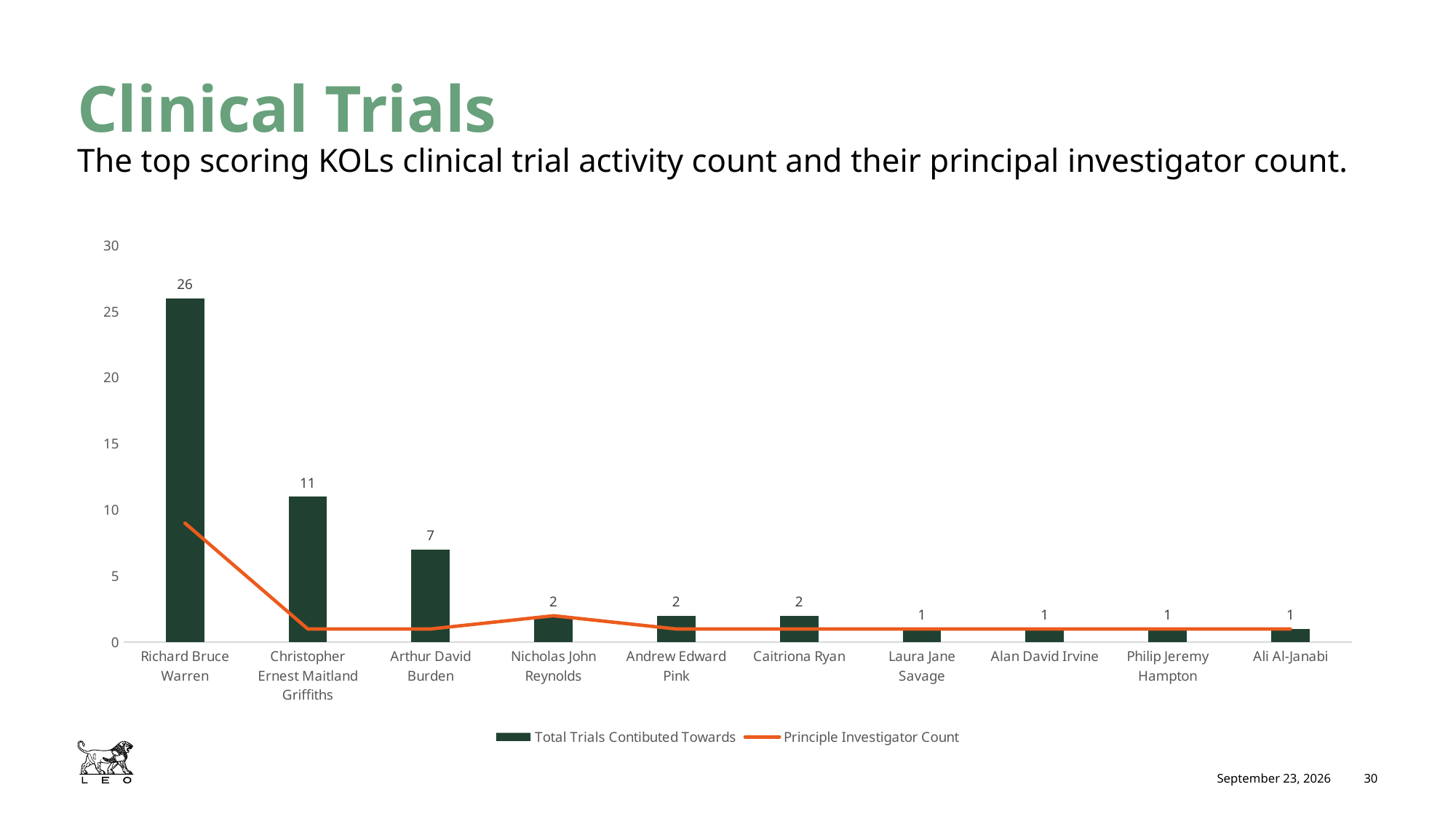
Do the Total Trials Contributed Towards values rise or fall from left to right along the x axis? fall What is the Total Trials Contributed Towards value for Caitriona Ryan? 2 Who has a higher Total Trials Contributed Towards value, Arthur David Burden or Nicholas John Reynolds? Arthur David Burden How many KOLs are shown on the x axis of the chart? 10 Is the Principle Investigator Count for Richard Bruce Warren greater or less than 5? greater Which series is shown as an orange line in the chart? Principle Investigator Count What is the Total Trials Contributed Towards value for Richard Bruce Warren? 26 Which KOL has the highest Total Trials Contributed Towards value? Richard Bruce Warren How many series does the chart legend list? 2 What is the Total Trials Contributed Towards value for Christopher Ernest Maitland Griffiths? 11 What is the Total Trials Contributed Towards value for Arthur David Burden? 7 What is the difference in Total Trials Contributed Towards between Richard Bruce Warren and Christopher Ernest Maitland Griffiths? 15